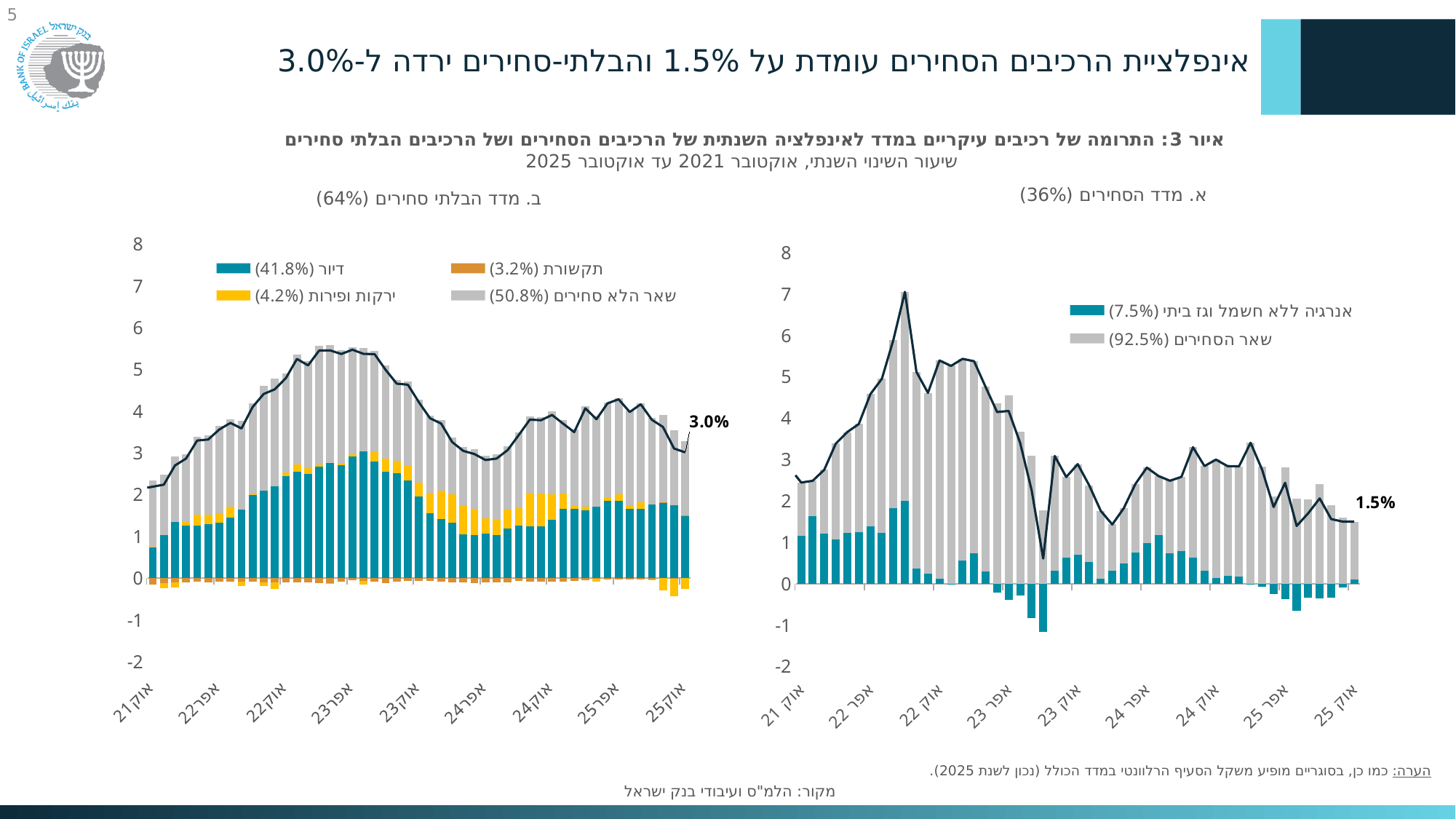
What kind of chart is the chart titled 'א. מדד הסחירים (36%)'? Stacked bar chart with a line In the chart titled 'ב. מדד הבלתי סחירים (64%)', what value is labelled at the end of the line for אוק 25? 3.0% In the chart titled 'א. מדד הסחירים (36%)', what value is labelled at the end of the line for אוק 25? 1.5% In the chart titled 'ב. מדד הבלתי סחירים (64%)', which legend entry has the share 41.8%? דיור In the chart titled 'א. מדד הסחירים (36%)', is the peak value of the line (around אוק 22) greater or less than 6? greater In the chart titled 'א. מדד הסחירים (36%)', what share is shown in the legend for 'שאר הסחירים'? 92.5% How many series does the legend list in the chart titled 'ב. מדד הבלתי סחירים (64%)'? 4 How many series does the legend list in the chart titled 'א. מדד הסחירים (36%)'? 2 In the chart titled 'א. מדד הסחירים (36%)', does the line rise or fall from אפר 25 to אוק 25? fall Which is larger: the final labelled value in the chart 'ב. מדד הבלתי סחירים (64%)' or the final labelled value in the chart 'א. מדד הסחירים (36%)'? ב. מדד הבלתי סחירים (64%) What is the difference between the final labelled value of the chart 'ב. מדד הבלתי סחירים (64%)' (3.0%) and that of the chart 'א. מדד הסחירים (36%)' (1.5%)? 1.5% In the chart titled 'ב. מדד הבלתי סחירים (64%)', is the value of the line at אוק 21 greater or less than 3? less